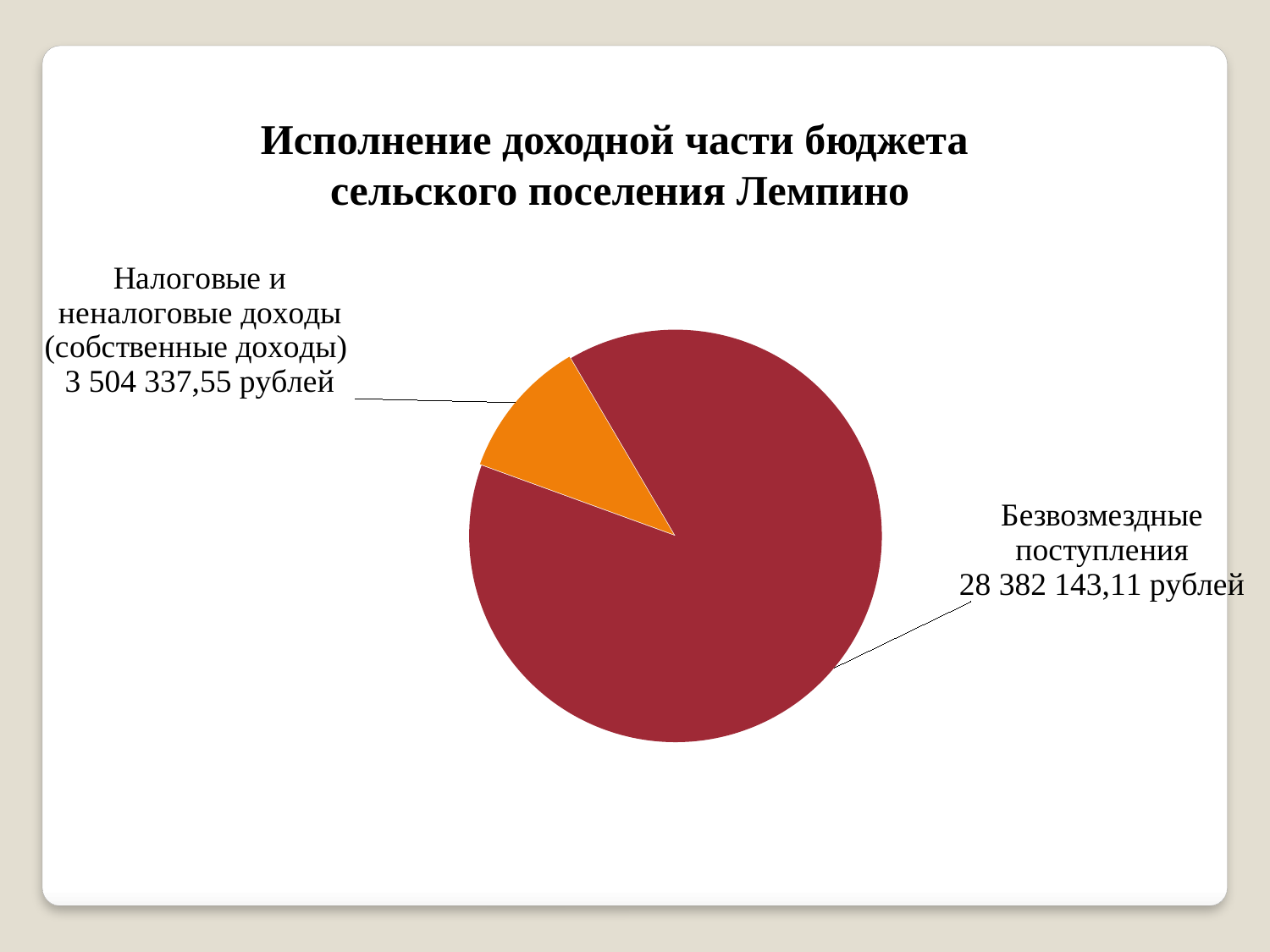
What kind of chart is shown on the slide? Pie chart What is the title of the chart? Исполнение доходной части бюджета сельского поселения Лемпино What is the value for Безвозмездные поступления? 28 382 143,11 рублей Which category has the largest slice of the pie? Безвозмездные поступления Which is larger: Безвозмездные поступления or Налоговые и неналоговые доходы (собственные доходы)? Безвозмездные поступления Which category has the smallest slice of the pie? Налоговые и неналоговые доходы (собственные доходы) How many slices does the pie chart have? 2 What colour is the slice for Налоговые и неналоговые доходы (собственные доходы)? Orange What is the value for Налоговые и неналоговые доходы (собственные доходы)? 3 504 337,55 рублей What is the total of the two slices in the pie chart? 31 886 480,66 рублей What is the difference between Безвозмездные поступления and Налоговые и неналоговые доходы (собственные доходы)? 24 877 805,56 рублей